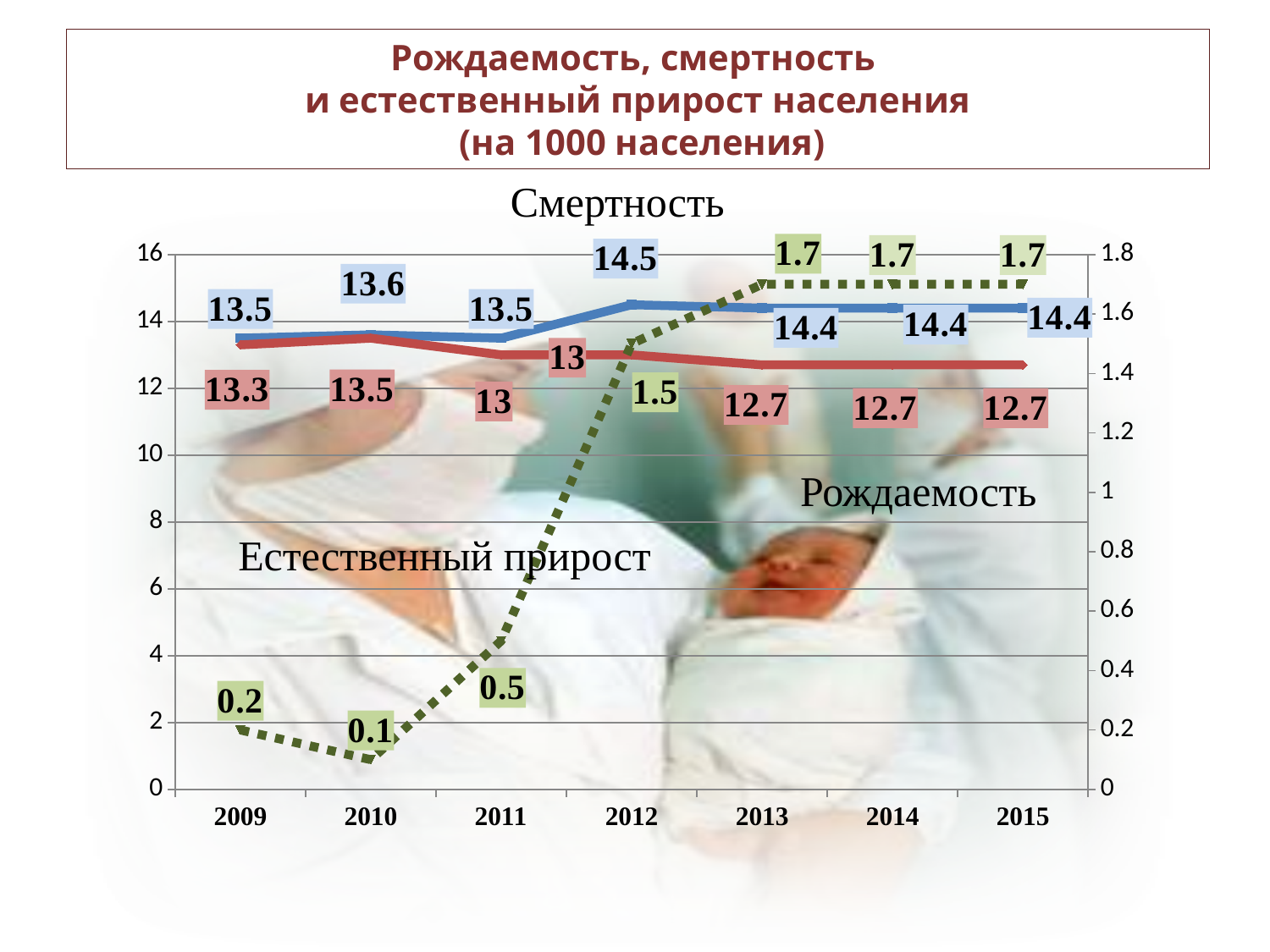
What is the value of the red line (Рождаемость) in 2009? 13.3 What type of chart is shown on the slide? line chart What is the title of the slide? Рождаемость, смертность и естественный прирост населения (на 1000 населения) In which year does the blue line (Смертность) reach its highest value? 2012 In which year does the green dotted line (Естественный прирост) have its lowest value? 2010 What is the value of the blue line (Смертность) in 2012? 14.5 What is the difference between the blue line (Смертность) and the red line (Рождаемость) in 2015? 1.7 How many years are shown on the x axis of the chart? 7 What is the value of the green dotted line (Естественный прирост) in 2010? 0.1 Which is larger in 2010: the blue line (Смертность) or the red line (Рождаемость)? Смертность (blue), 13.6 Does the green dotted line (Естественный прирост) rise or fall between 2010 and 2013? rise How many lines (series) are plotted on the chart? 3